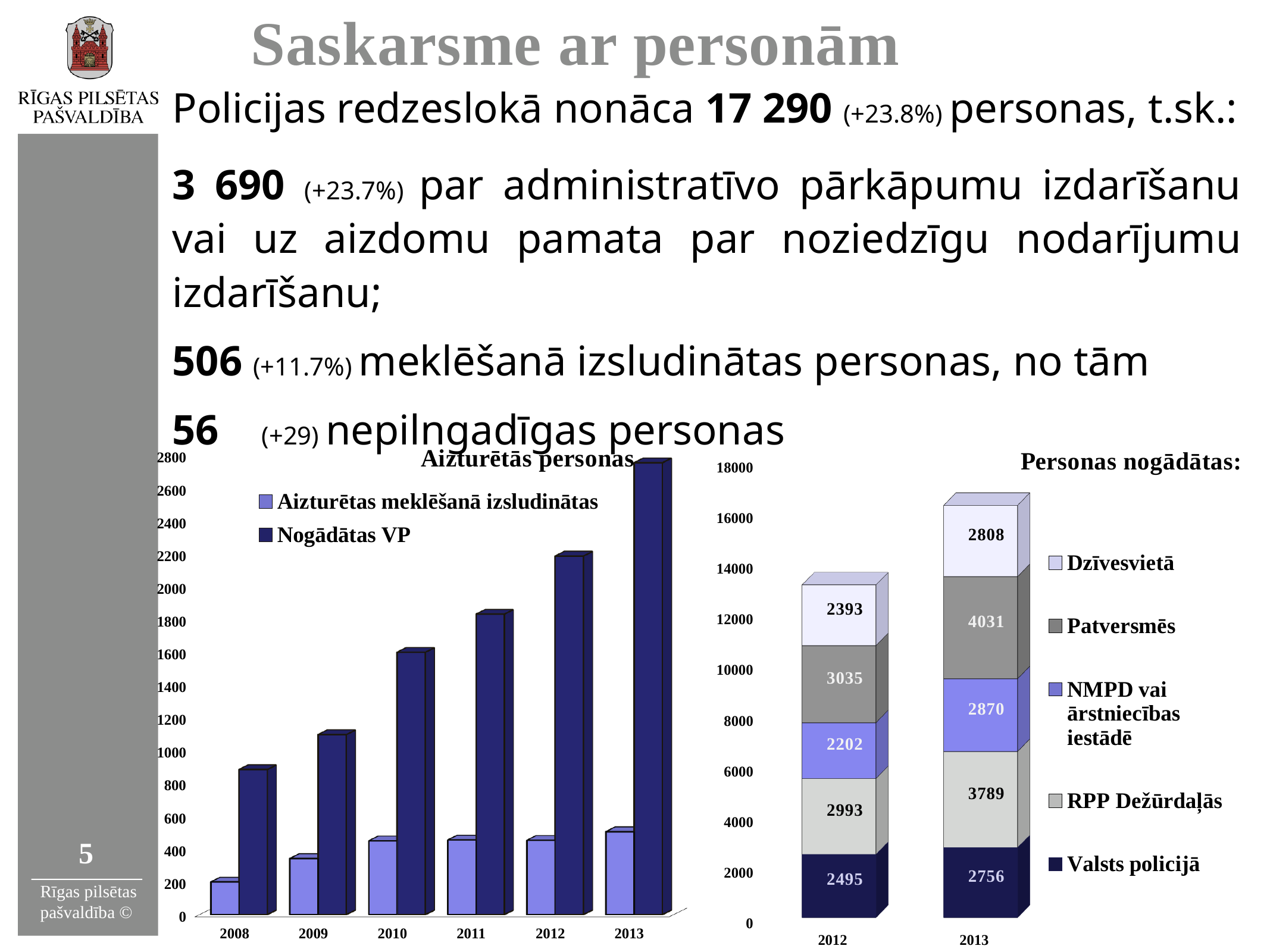
In the 'Personas nogādātas:' chart, what is the total of the stacked bar for 2012? 13118 In the 'Personas nogādātas:' chart, what is the value for Valsts policijā in 2012? 2495 In the 'Aizturētās personas' chart, is the value for Nogādātas VP in 2010 greater or less than 1400? greater In the 'Personas nogādātas:' chart, how many series does the legend list? 5 In the 'Aizturētās personas' chart, how many years are shown on the x axis? 6 In the 'Personas nogādātas:' chart, what is the total of the stacked bar for 2013? 16254 In the 'Aizturētās personas' chart, do the Nogādātas VP values rise or fall from 2008 to 2013? rise In the 'Personas nogādātas:' chart, what is the value for Patversmēs in 2013? 4031 In the 'Personas nogādātas:' chart, which segment is the largest in the 2013 bar? Patversmēs In the 'Personas nogādātas:' chart, what is the difference between the Patversmēs values for 2013 and 2012? 996 In the 'Personas nogādātas:' chart, what is the value for Dzīvesvietā in 2013? 2808 In the 'Aizturētās personas' chart, which year has the highest value for Nogādātas VP? 2013